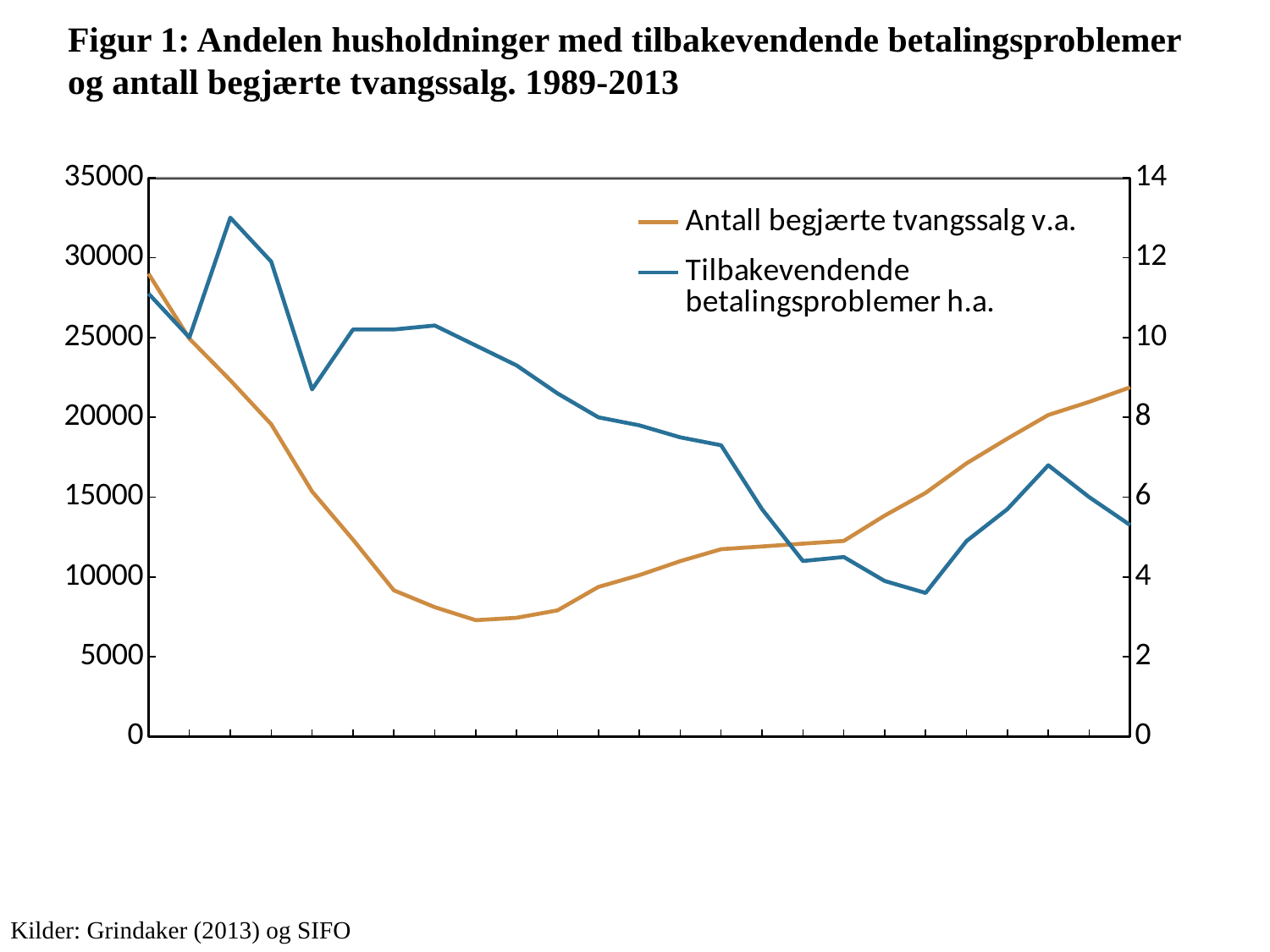
Is the lowest point of the Antall begjærte tvangssalg line greater or less than 10000? less How many series does the legend list? 2 What is the title of the chart? Figur 1: Andelen husholdninger med tilbakevendende betalingsproblemer og antall begjærte tvangssalg. 1989-2013 Is the highest point of the Tilbakevendende betalingsproblemer line greater or less than 12 on the right axis? greater Comparing the left end to the right end of the chart, does the Antall begjærte tvangssalg line rise or fall overall? fall Is the value of Tilbakevendende betalingsproblemer at the right end of the chart greater or less than 6 on the right axis? less Comparing the left end to the right end of the chart, does the Tilbakevendende betalingsproblemer line rise or fall overall? fall What kind of chart is shown on the slide? line chart Which series is plotted in orange? Antall begjærte tvangssalg v.a.